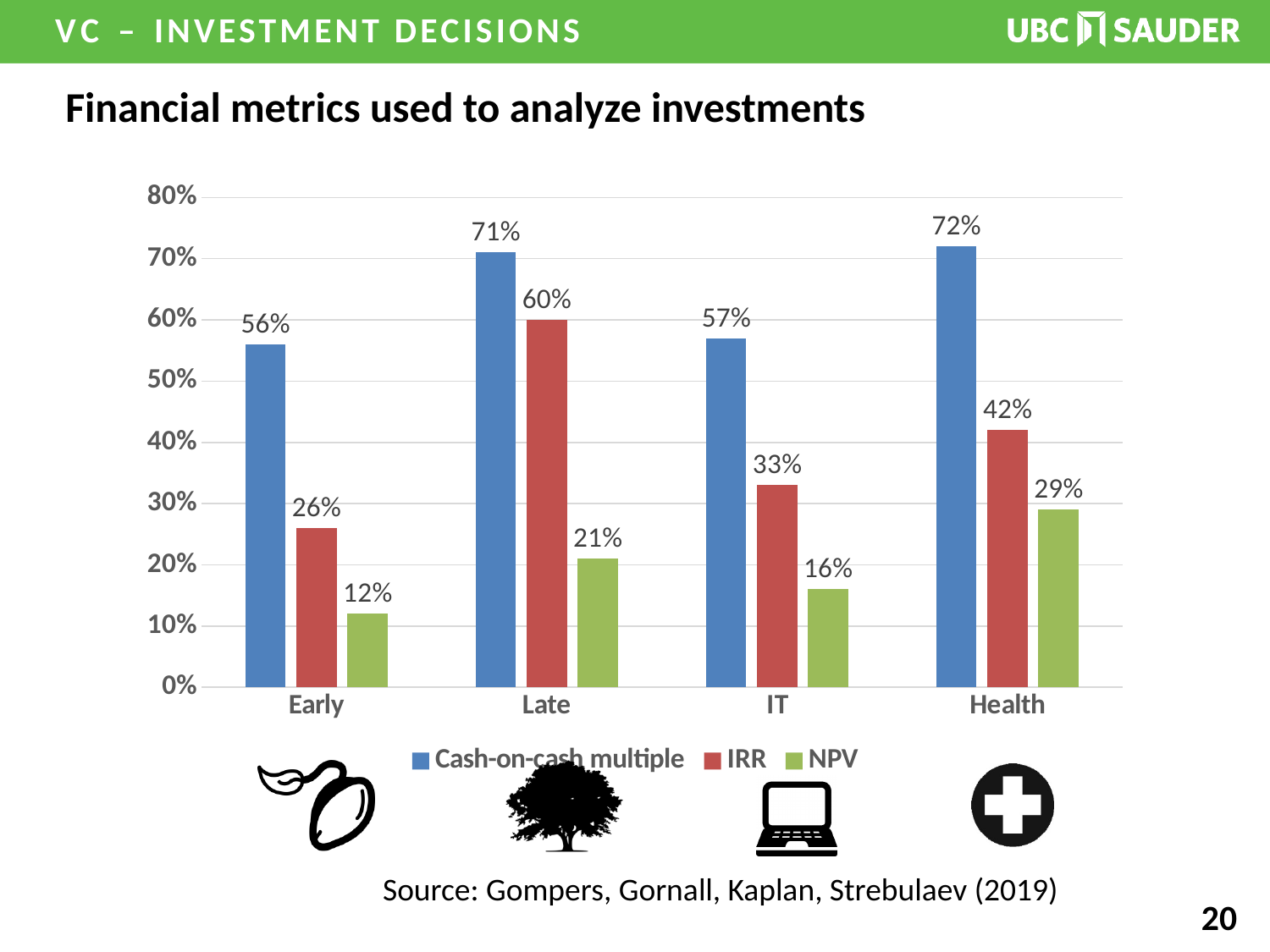
What is the title of the slide's chart section? Financial metrics used to analyze investments What is the NPV value for Early? 12% What is the IRR value for Health? 42% What is the difference between the IRR values for Late and IT? 27% Which category has the highest Cash-on-cash multiple value? Health What is the Cash-on-cash multiple value for Late? 71% Which is larger, the NPV value for Late or the NPV value for IT? Late How many categories are shown on the x axis? 4 Which series is shown in green in the legend? NPV Which category has the lowest NPV value? Early What kind of chart is shown on the slide? bar chart How many series does the legend list? 3